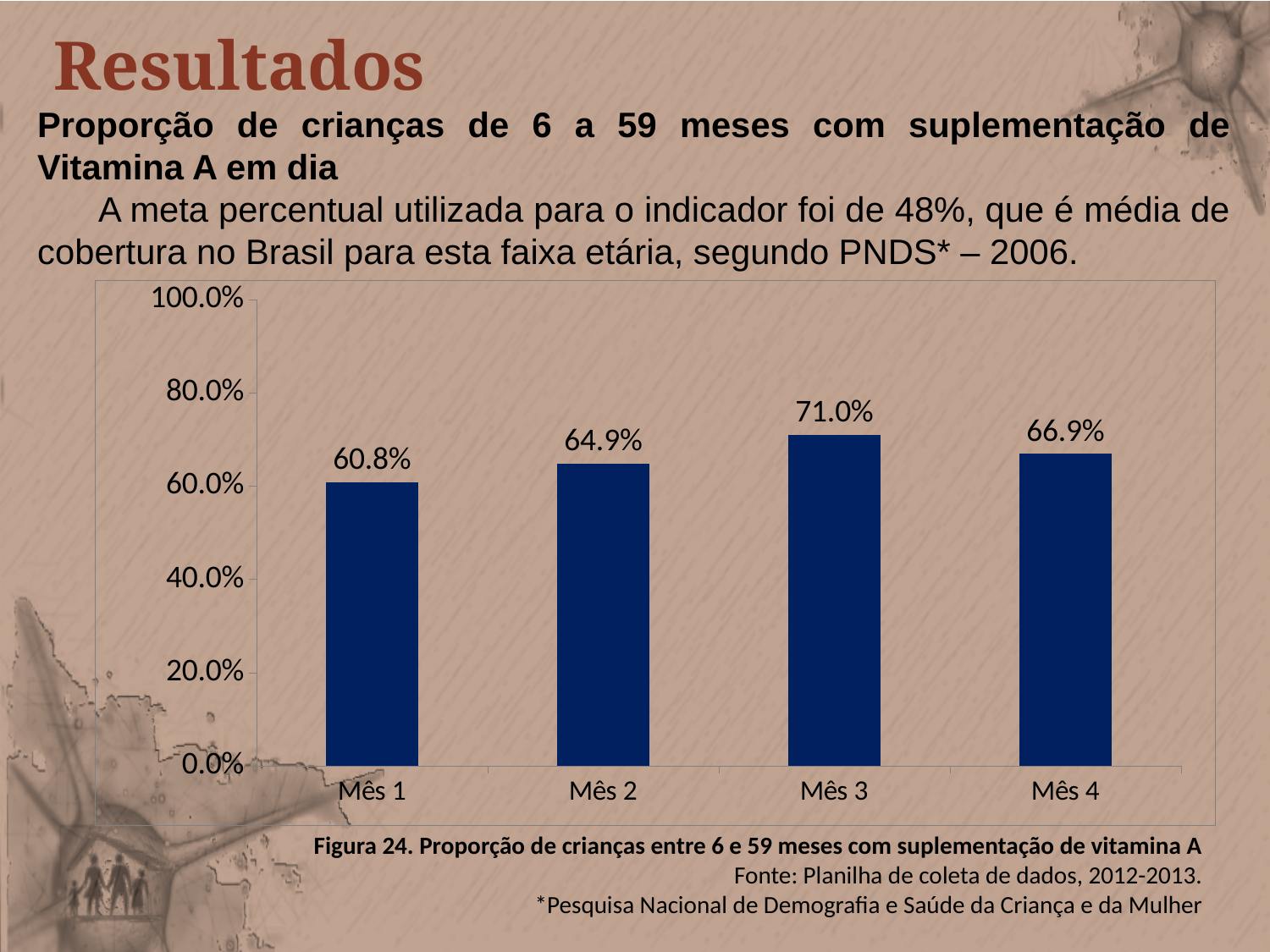
What is the value for Mês 1? 60.8% Is the value for Mês 3 greater or less than 80.0%? less What is the value for Mês 3? 71.0% What is the figure caption below the chart? Figura 24. Proporção de crianças entre 6 e 59 meses com suplementação de vitamina A Which is larger, the value for Mês 2 or the value for Mês 4? Mês 4 How many months are shown on the x axis? 4 Which month has the lowest value? Mês 1 What is the difference between the values for Mês 3 and Mês 1? 10.2% What is the difference between the values for Mês 2 and Mês 1? 4.1% What is the value for Mês 4? 66.9% What kind of chart is shown on the slide? bar chart Which month has the highest value? Mês 3